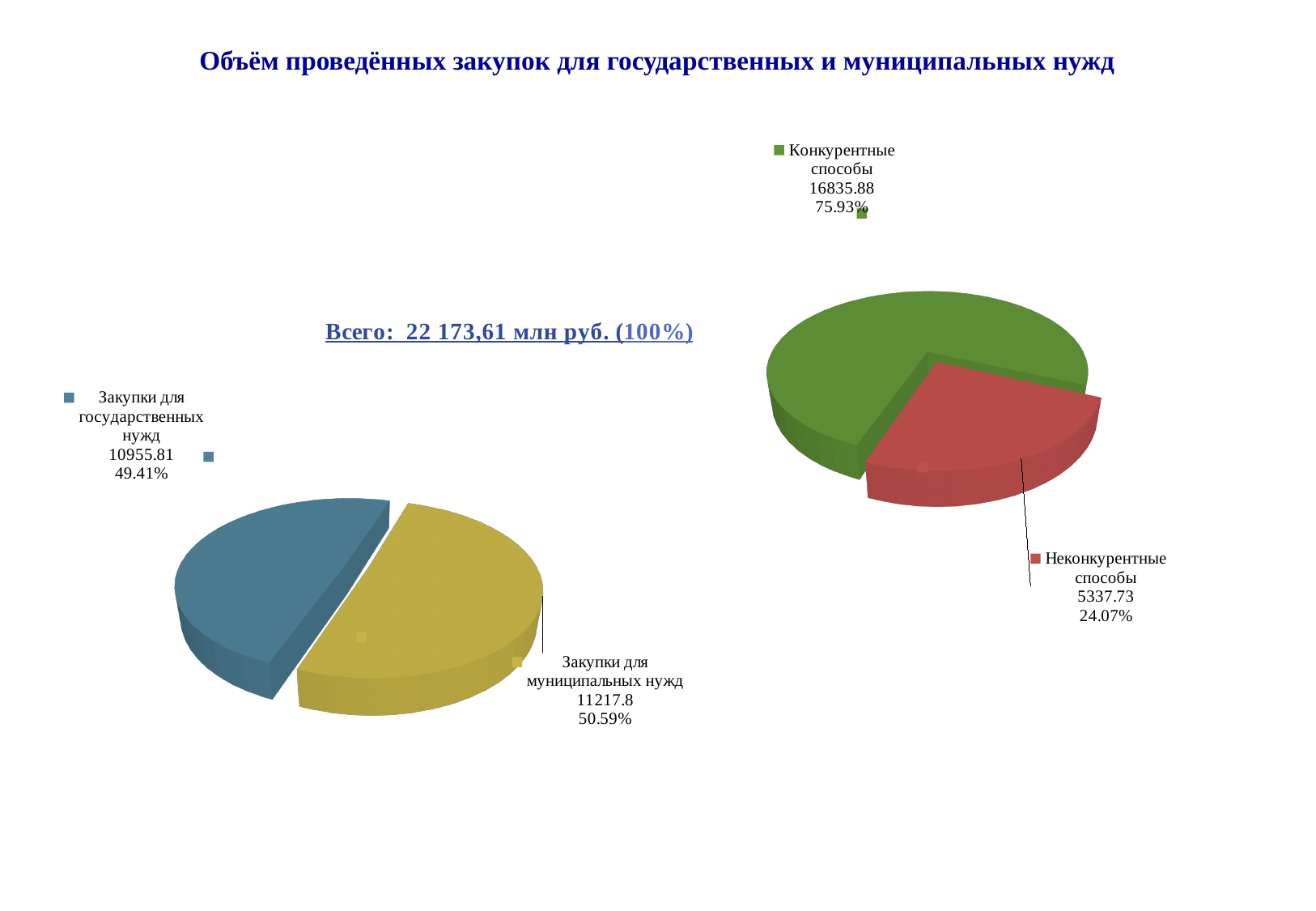
What type of chart is shown on the left of the slide? pie chart In the right pie chart, what is the value for Конкурентные способы? 16835.88 In the right pie chart, which slice is the smallest? Неконкурентные способы In the right pie chart, which is larger: Конкурентные способы or Неконкурентные способы? Конкурентные способы In the left pie chart, what is the difference between the values for Закупки для муниципальных нужд and Закупки для государственных нужд? 261.99 How many slices does the left pie chart have? 2 In the left pie chart, what is the value for Закупки для муниципальных нужд? 11217.8 What colour is the Неконкурентные способы slice in the right pie chart? red In the right pie chart, what share does Неконкурентные способы have? 24.07% In the right pie chart, what is the difference between the values for Конкурентные способы and Неконкурентные способы? 11498.15 In the right pie chart, which slice is the largest? Конкурентные способы In the left pie chart, what share does Закупки для государственных нужд have? 49.41%